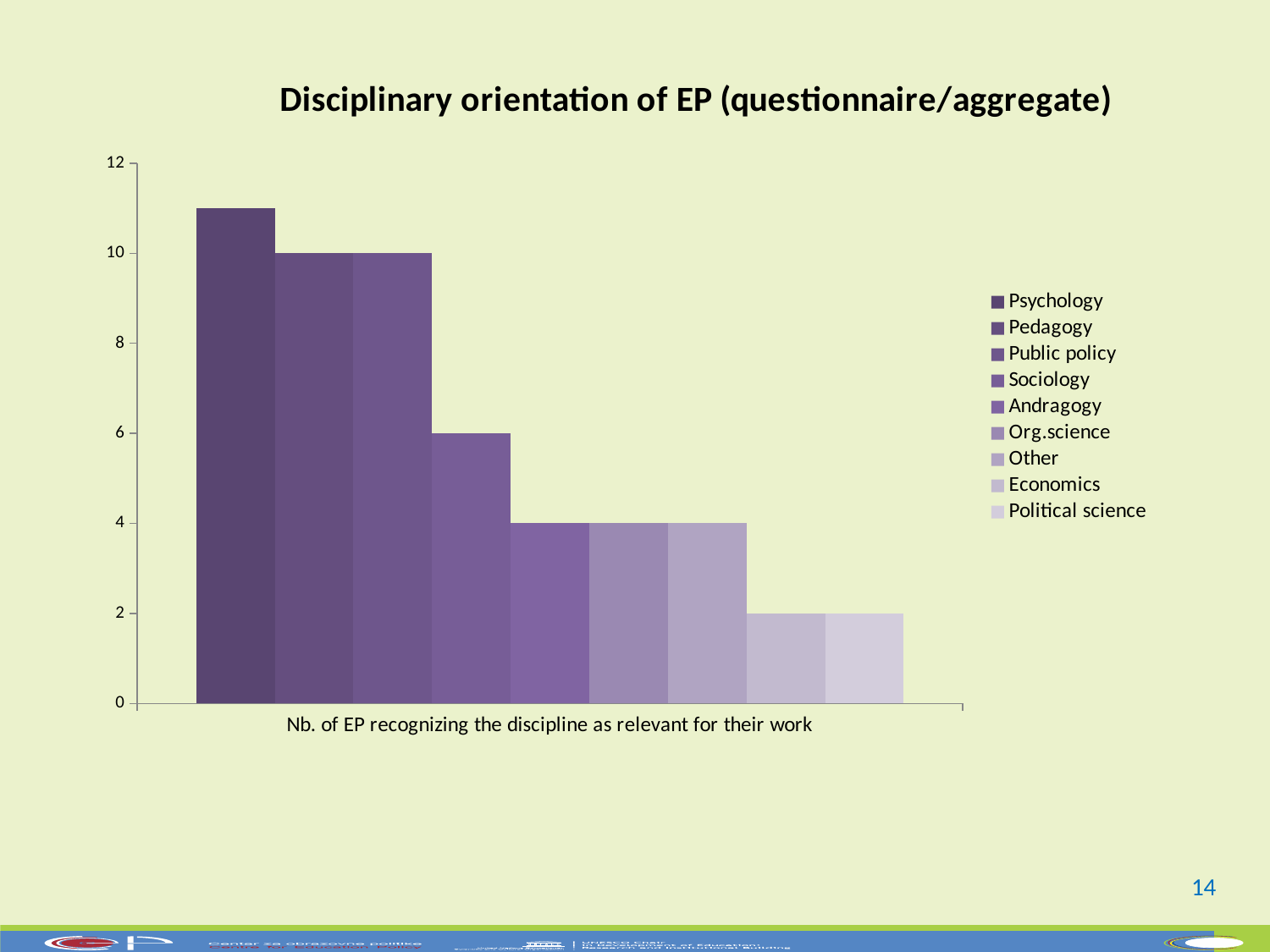
What is the value for Sociology? 6 What is the value for Andragogy? 4 Which is larger, the value for Sociology or the value for Org.science? Sociology What type of chart is shown on the slide? bar chart What is the title of the chart? Disciplinary orientation of EP (questionnaire/aggregate) Is the value for Psychology greater or less than 10? greater How many series does the legend list? 9 Which discipline has the highest value? Psychology What is the value for Pedagogy? 10 What is the difference between the values for Pedagogy and Sociology? 4 Do the bar values rise or fall from left to right across the chart? fall What is the value for Economics? 2